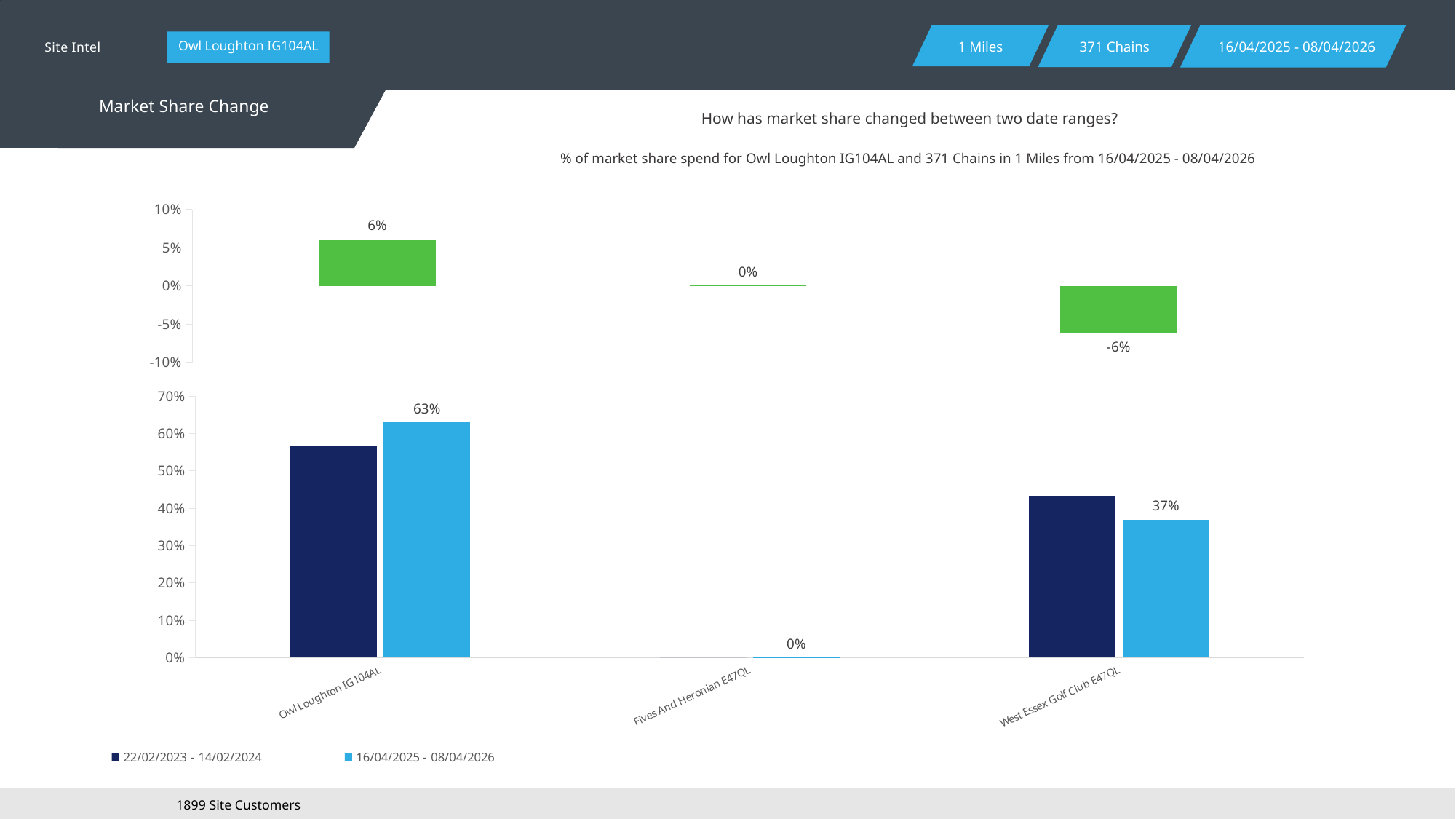
How many categories are shown on the x axis of the bottom chart? 3 What type of chart is the bottom chart? Bar chart In the bottom chart, what is the value for Owl Loughton IG104AL in the 16/04/2025 - 08/04/2026 series? 63% In the bottom chart, what is the value for West Essex Golf Club E47QL in the 16/04/2025 - 08/04/2026 series? 37% In the top chart, what is the market share change for Owl Loughton IG104AL? 6% In the bottom chart, what is the difference between the 16/04/2025 - 08/04/2026 values for Owl Loughton IG104AL and West Essex Golf Club E47QL? 26% In the top chart, which category has the lowest market share change? West Essex Golf Club E47QL In the top chart, what is the market share change for West Essex Golf Club E47QL? -6% In the top chart, what is the market share change for Fives And Heronian E47QL? 0% In the bottom chart, how many series does the legend list? 2 In the bottom chart, is the 22/02/2023 - 14/02/2024 value for West Essex Golf Club E47QL greater or less than 50%? less In the bottom chart, is the 22/02/2023 - 14/02/2024 value for Owl Loughton IG104AL greater or less than 50%? greater